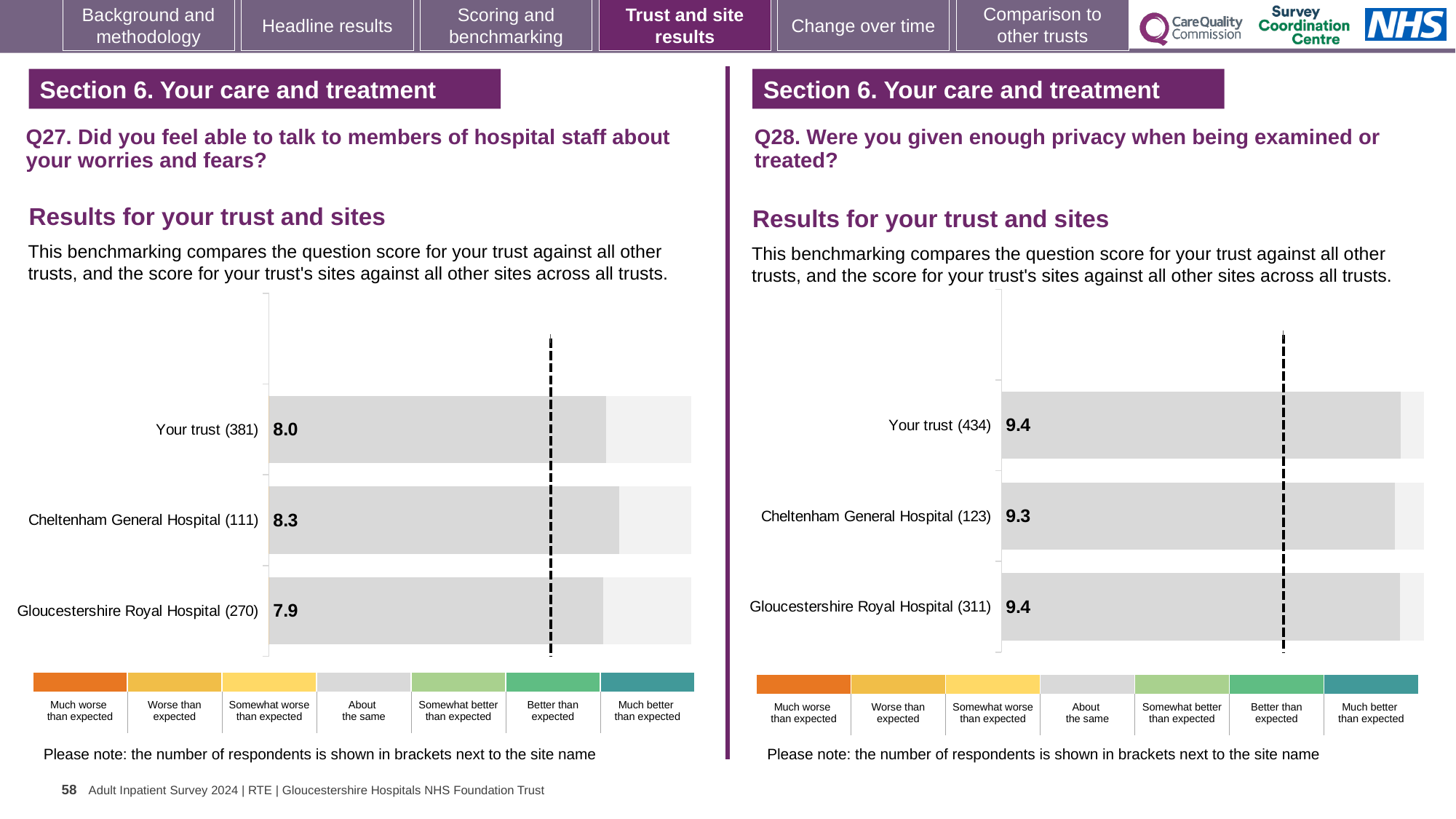
In the Q27 chart on the left, which site or trust has the lowest score? Gloucestershire Royal Hospital (270) In the Q27 chart on the left, which site or trust has the highest score? Cheltenham General Hospital (111) In the Q27 chart on the left, what is the difference between the scores for Cheltenham General Hospital and Gloucestershire Royal Hospital? 0.4 How many bars are plotted in the Q27 chart on the left? 3 What kind of chart is the Q28 chart on the right? Bar chart In the Q28 chart on the right, which is larger: the score for Your trust or the score for Cheltenham General Hospital? Your trust In the Q28 chart on the right, what is the score for Your trust (434)? 9.4 In the Q28 chart on the right, what is the score for Cheltenham General Hospital (123)? 9.3 In the Q27 chart on the left, what is the score for Cheltenham General Hospital (111)? 8.3 In the Q27 chart on the left, what is the score for Your trust (381)? 8.0 In the Q27 chart on the left, what is the score for Gloucestershire Royal Hospital (270)? 7.9 In the Q28 chart on the right, what is the score for Gloucestershire Royal Hospital (311)? 9.4